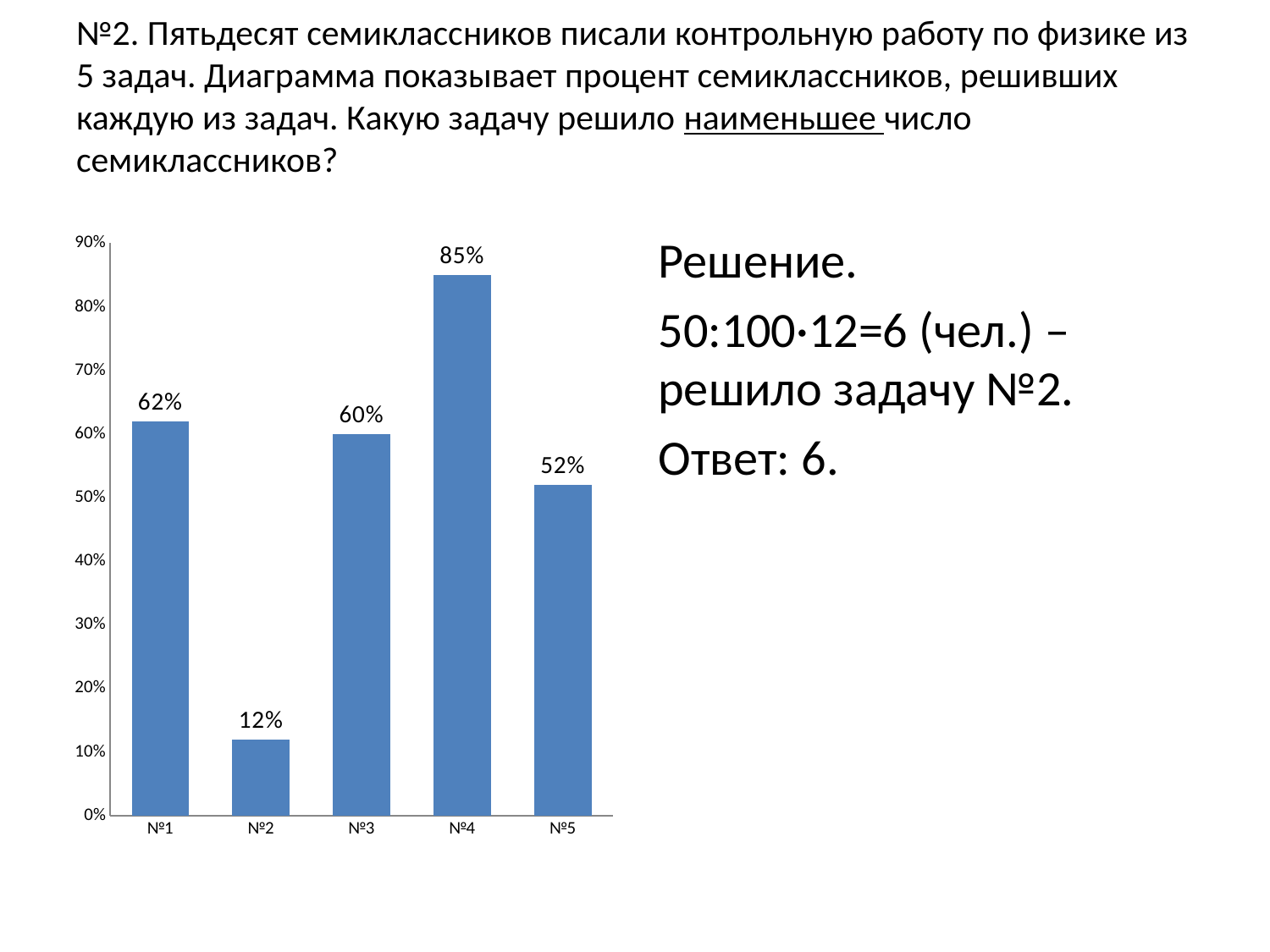
Which problem has a higher percentage, №3 or №5? №3 What percentage of students solved problem №1? 62% What is the highest value shown on the vertical axis of the chart? 90% Which problem was solved by the highest percentage of students? №4 What percentage of students solved problem №2? 12% What type of chart is shown on the slide? Bar chart Which problem was solved by the lowest percentage of students? №2 What is the difference between the percentages for problem №4 and problem №2? 73% How many problems (categories) are shown on the chart? 5 What percentage of students solved problem №5? 52% What percentage of students solved problem №4? 85% What is the difference between the percentages for problem №1 and problem №3? 2%